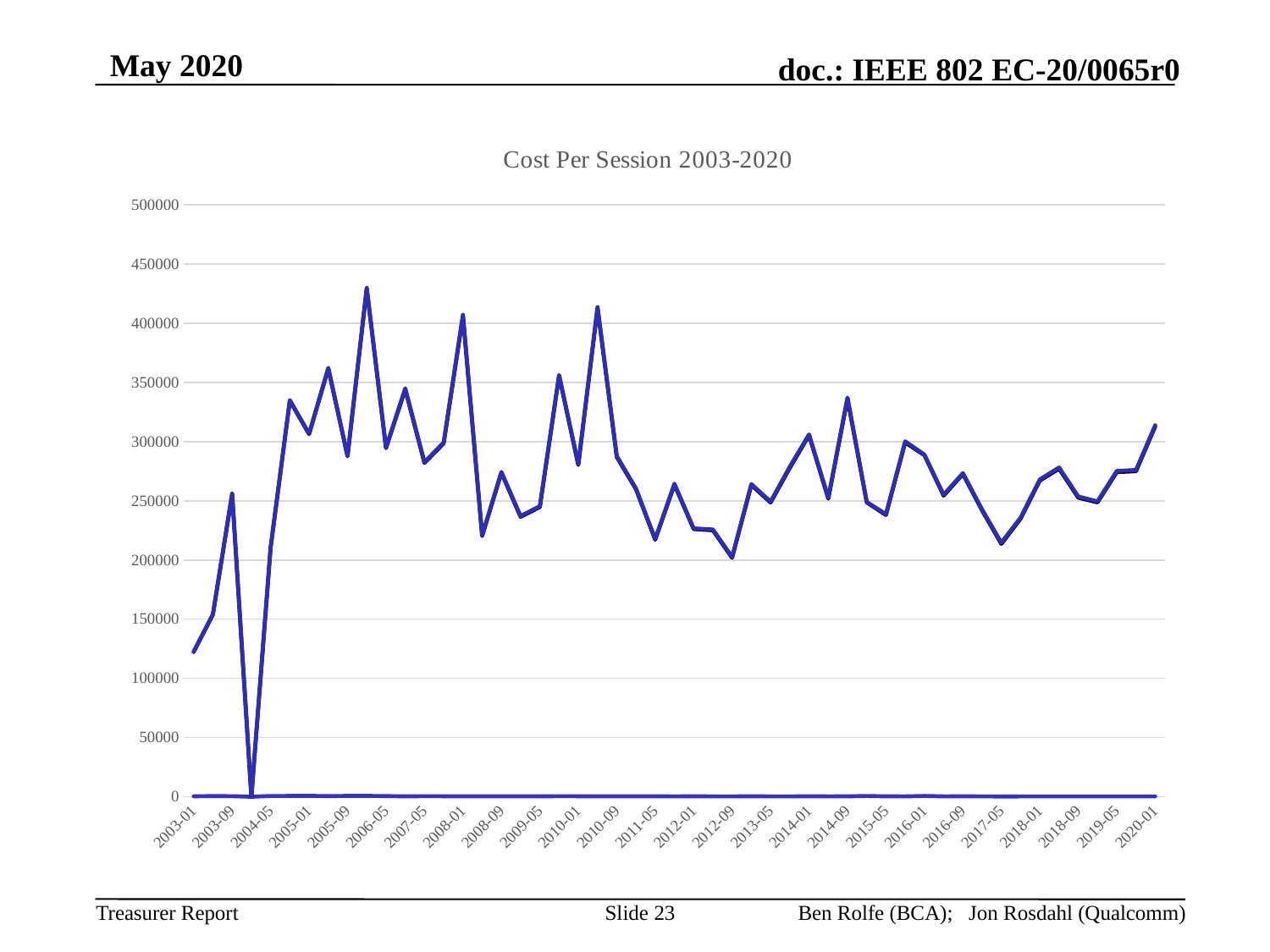
What is the step between consecutive tick marks on the y axis? 50000 What is the last category label on the x axis? 2020-01 Is the highest point on the line greater or less than 400000? greater What is the title of the chart? Cost Per Session 2003-2020 What is the highest value shown on the y axis? 500000 Between 2003-01 and 2003-09, does the value rise or fall? rise What kind of chart is shown on the slide? line chart Is the value for 2003-09 greater or less than 200000? greater What is the first category label on the x axis? 2003-01 Is the value for 2020-01 greater or less than 300000? greater Which is larger, the value for 2003-01 or the value for 2020-01? 2020-01